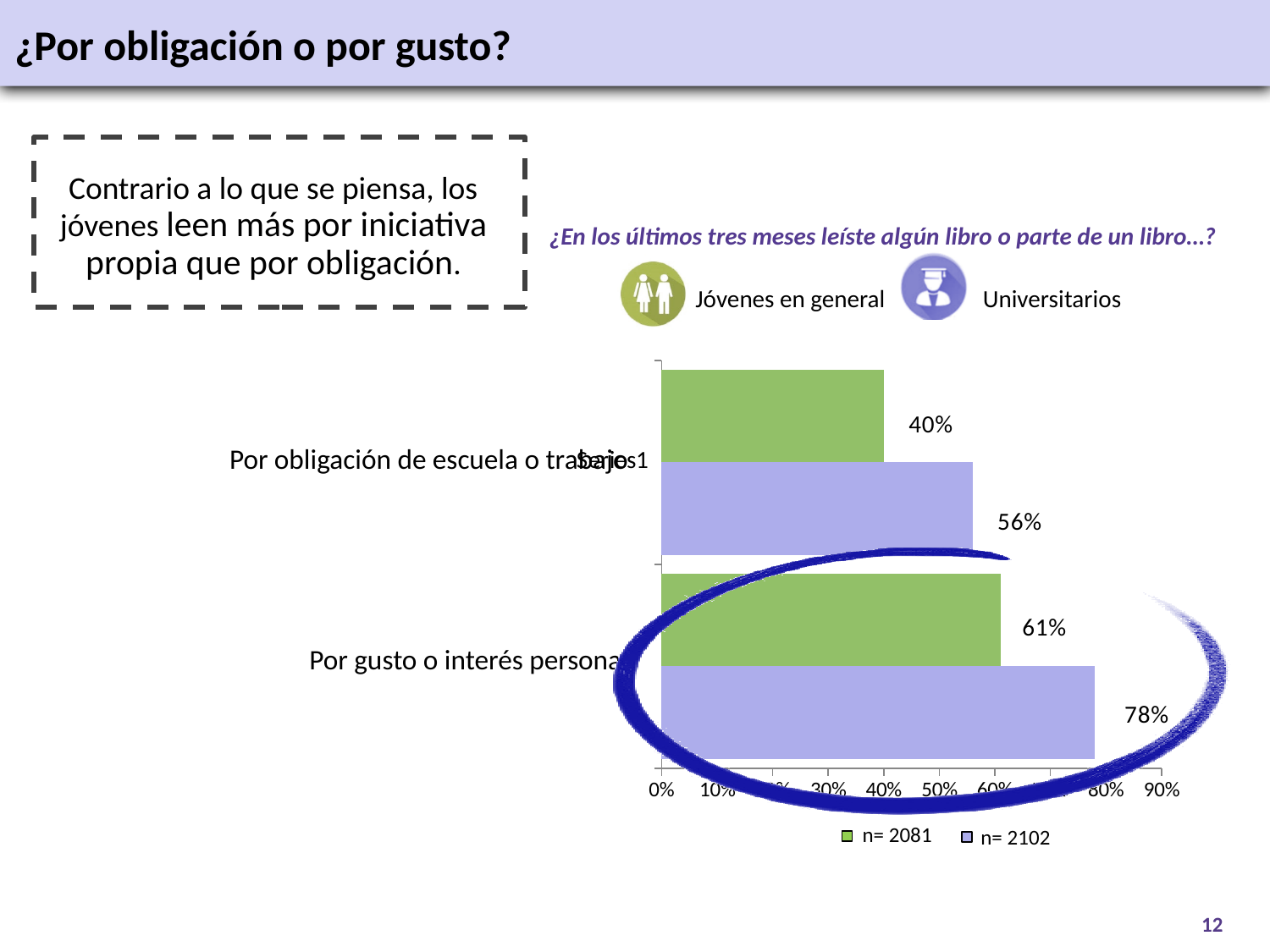
What is the value of the green bar (Jóvenes en general) for 'Por gusto o interés personal'? 61% What is the value of the green bar (Jóvenes en general) for 'Por obligación de escuela o trabajo'? 40% What is the value of the purple bar (Universitarios) for 'Por gusto o interés personal'? 78% What is the difference between the Universitarios and Jóvenes en general values for 'Por gusto o interés personal'? 17% What type of chart is shown on the slide? bar chart How many series does the chart legend list? 2 What are the two legend entries shown below the chart? n= 2081 and n= 2102 For Jóvenes en general, which is larger: 'Por obligación de escuela o trabajo' or 'Por gusto o interés personal'? Por gusto o interés personal What is the difference between the Universitarios and Jóvenes en general values for 'Por obligación de escuela o trabajo'? 16% What is the value of the purple bar (Universitarios) for 'Por obligación de escuela o trabajo'? 56% Which bar in the chart has the highest value? Universitarios, Por gusto o interés personal (78%) Which bar in the chart has the lowest value? Jóvenes en general, Por obligación de escuela o trabajo (40%)